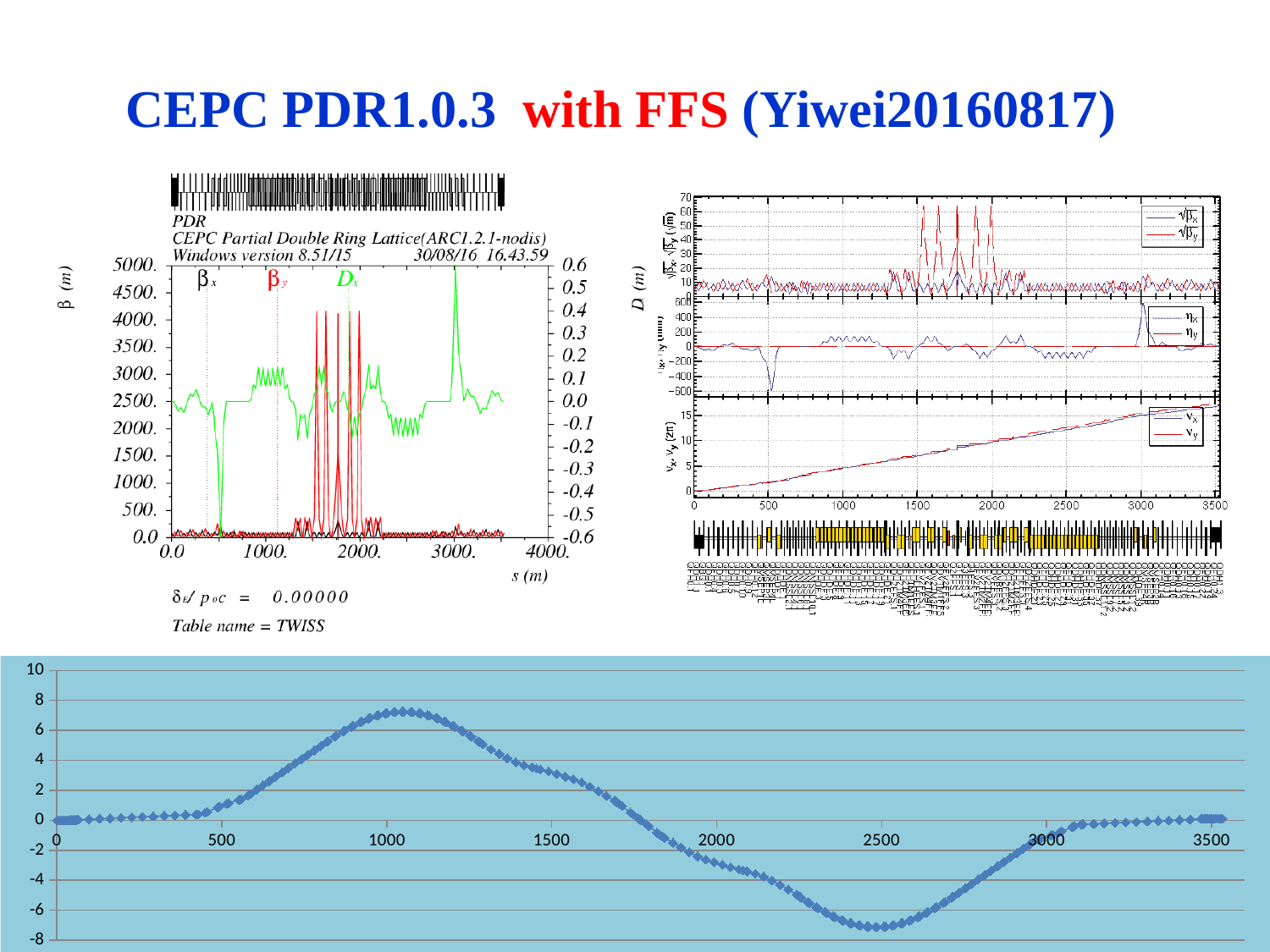
What kind of chart is the bottom chart on the slide? line chart In the middle panel of the top-right chart, how many series does the legend list? 2 In the bottom chart, do the values rise or fall between x = 1000 and x = 2500? fall In the bottom panel of the top-right chart (νx, νy), do the values rise or fall along the x axis? rise In the top-left chart, how many series are labelled in the plot area? 3 In the bottom chart, is the value at x = 500 greater or less than 2? less In the top-left chart, what is the maximum value shown on the left vertical axis (β)? 5000. In the bottom chart, is the value at x = 2000 greater or less than 0? less In the top-left chart, what is the value of δE/p0c printed below the plot? 0.00000 In the bottom chart, what is the highest value shown on the vertical axis? 10 In the bottom chart, is the value at x = 2500 greater or less than -6? less